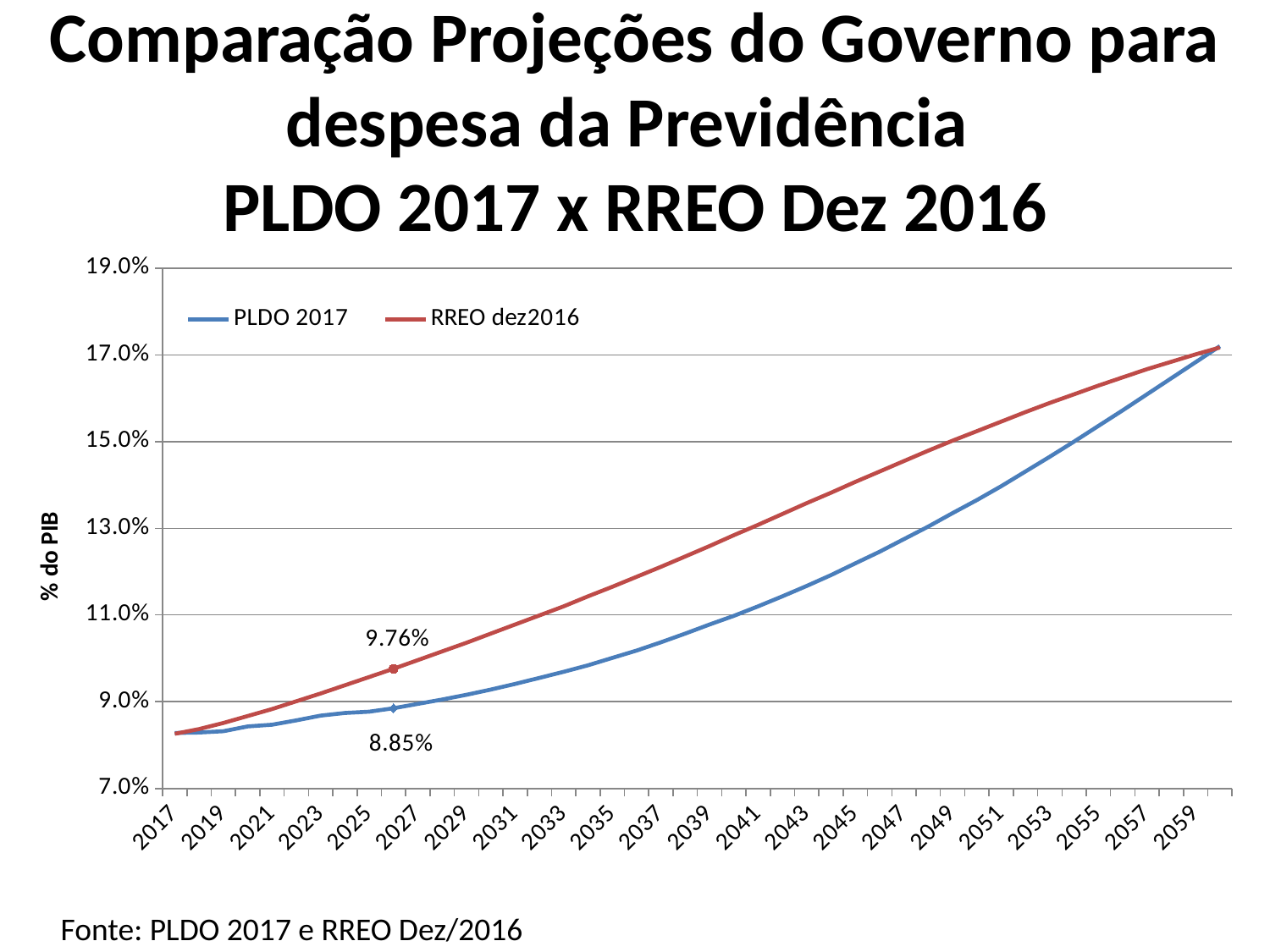
What is the label of the vertical axis? % do PIB What value is labeled on the RREO dez2016 line? 9.76% What is the difference between the two labeled values, 9.76% and 8.85%? 0.91 percentage points How many series does the legend list? 2 What kind of chart is shown on the slide? line chart At the labeled points, which series has the larger value, PLDO 2017 or RREO dez2016? RREO dez2016 Is the value for PLDO 2017 in 2053 greater or less than 13.0%? greater In 2045, which series is higher, PLDO 2017 or RREO dez2016? RREO dez2016 Which series is drawn in red? RREO dez2016 Is the value for RREO dez2016 in 2029 greater or less than 11.0%? less What value is labeled on the PLDO 2017 line? 8.85% Do the values of the PLDO 2017 series rise or fall from 2017 to 2059? rise